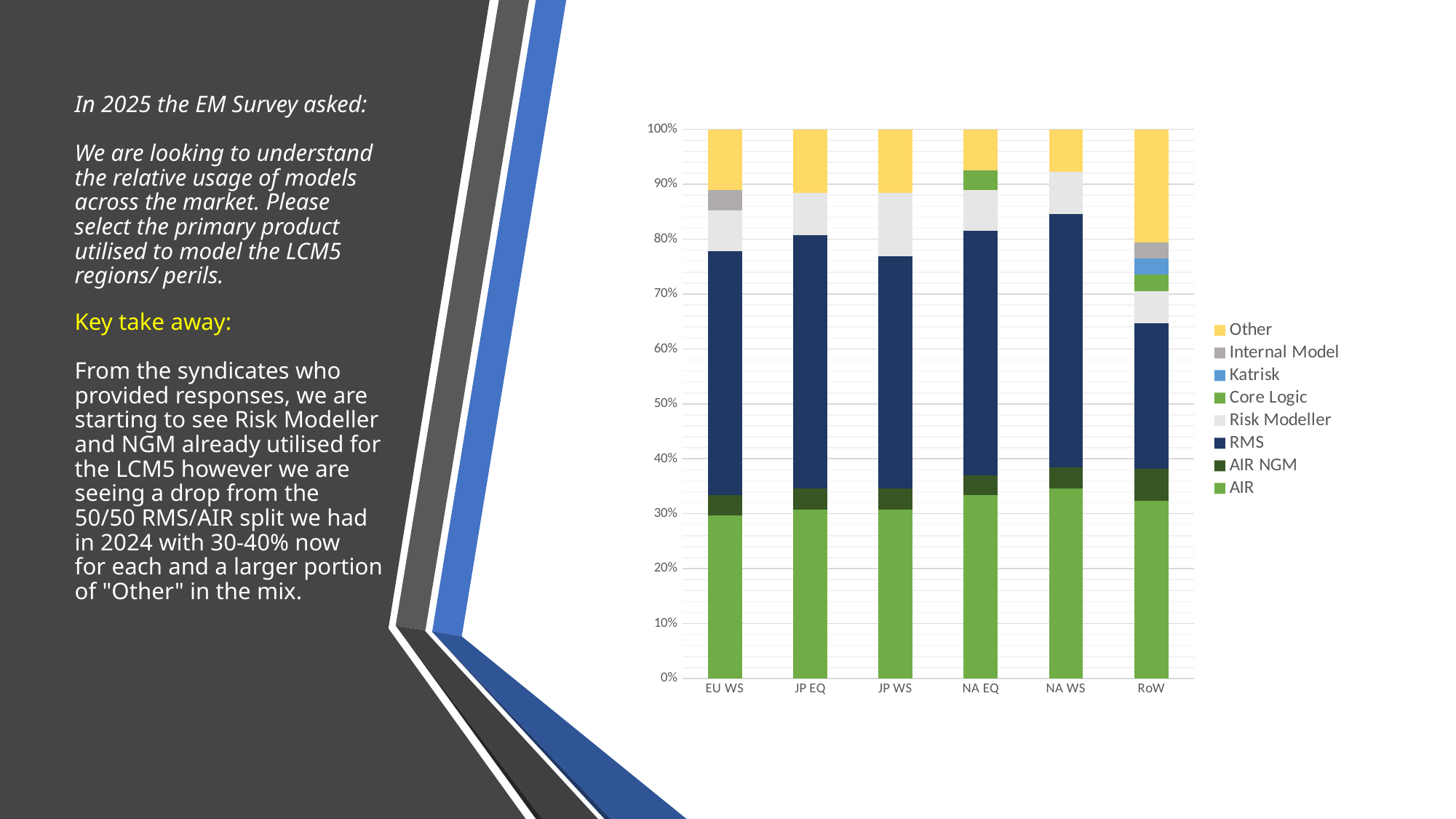
How many series does the chart's legend list? 8 Is the top of the RMS segment for RoW greater or less than 70%? less Which category has the largest 'Other' share in the chart? RoW Which categories include a Core Logic segment? NA EQ and RoW Is the top of the RMS segment for NA WS greater or less than 80%? greater Which category has the smallest RMS share in the chart? RoW Is the AIR share for NA EQ greater or less than 30%? greater How many categories are shown along the x axis of the chart? 6 What kind of chart is shown on the slide? Stacked bar chart What is the maximum value shown on the chart's y axis? 100% Which category is the only one that includes a Katrisk segment? RoW Is the RMS share for NA WS larger or smaller than the RMS share for RoW? Larger